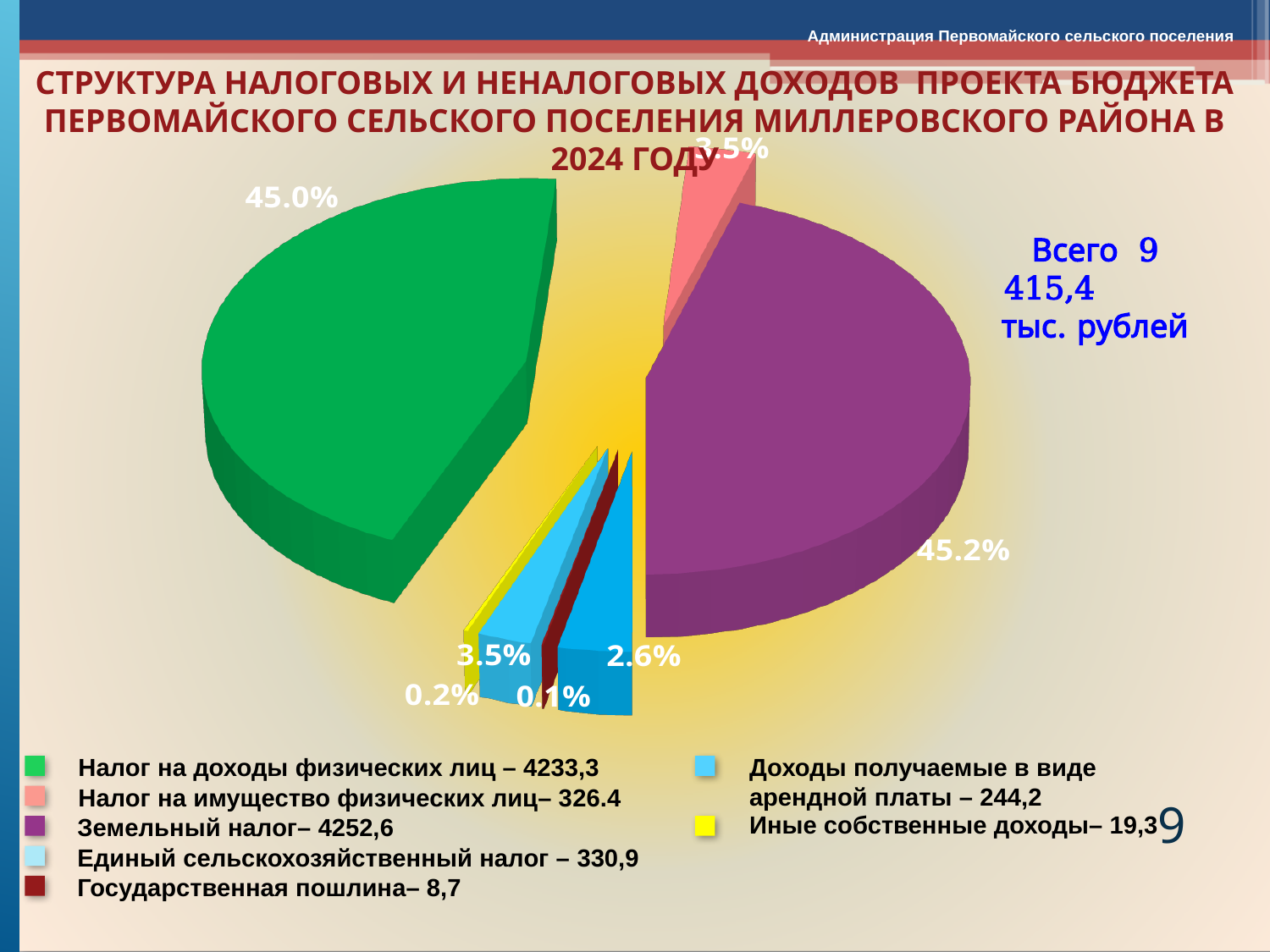
By how many percentage points does the share of Земельный налог exceed the share of Налог на доходы физических лиц? 0.2 What share of the pie does Доходы получаемые в виде арендной платы have? 2.6% What share of the pie does Налог на доходы физических лиц have? 45.0% What value is given in the legend for Иные собственные доходы? 19,3 Which is larger: the value for Земельный налог or the value for Налог на доходы физических лиц? Земельный налог What total amount is stated next to the pie chart? 9 415,4 тыс. рублей Which category has the largest share of the pie? Земельный налог (45.2%) Which category has the smallest share of the pie? Государственная пошлина (0.1%) What value is given in the legend for Налог на имущество физических лиц? 326.4 What value is given in the legend for Единый сельскохозяйственный налог? 330,9 What kind of chart is shown on the slide? pie chart How many categories does the legend of the pie chart list? 7